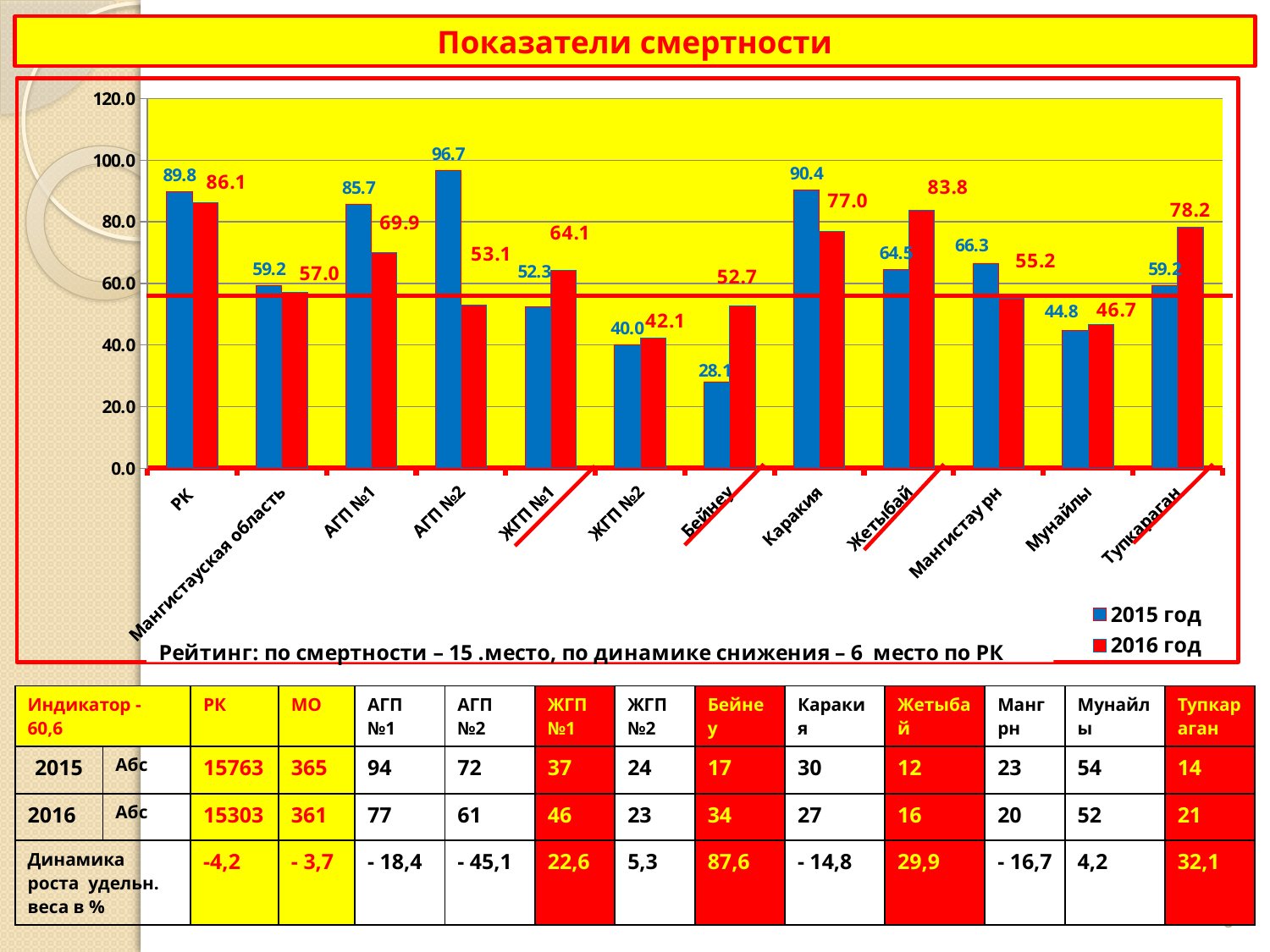
Which is larger for Тупкараган: the 2015 год value or the 2016 год value? 2016 год What is the 2016 год value for Жетыбай? 83.8 Which category has the lowest 2016 год value? ЖГП №2 What is the title of the chart? Показатели смертности How many categories are shown along the x axis of the chart? 12 What type of chart is shown on the slide? bar chart Which category has the highest 2015 год value? АГП №2 Which category has the lowest 2015 год value? Бейнеу What is the 2016 год value for Бейнеу? 52.7 What is the 2015 год value for АГП №2? 96.7 How many series does the chart legend list? 2 What is the difference between the 2015 год and 2016 год values for АГП №2? 43.6